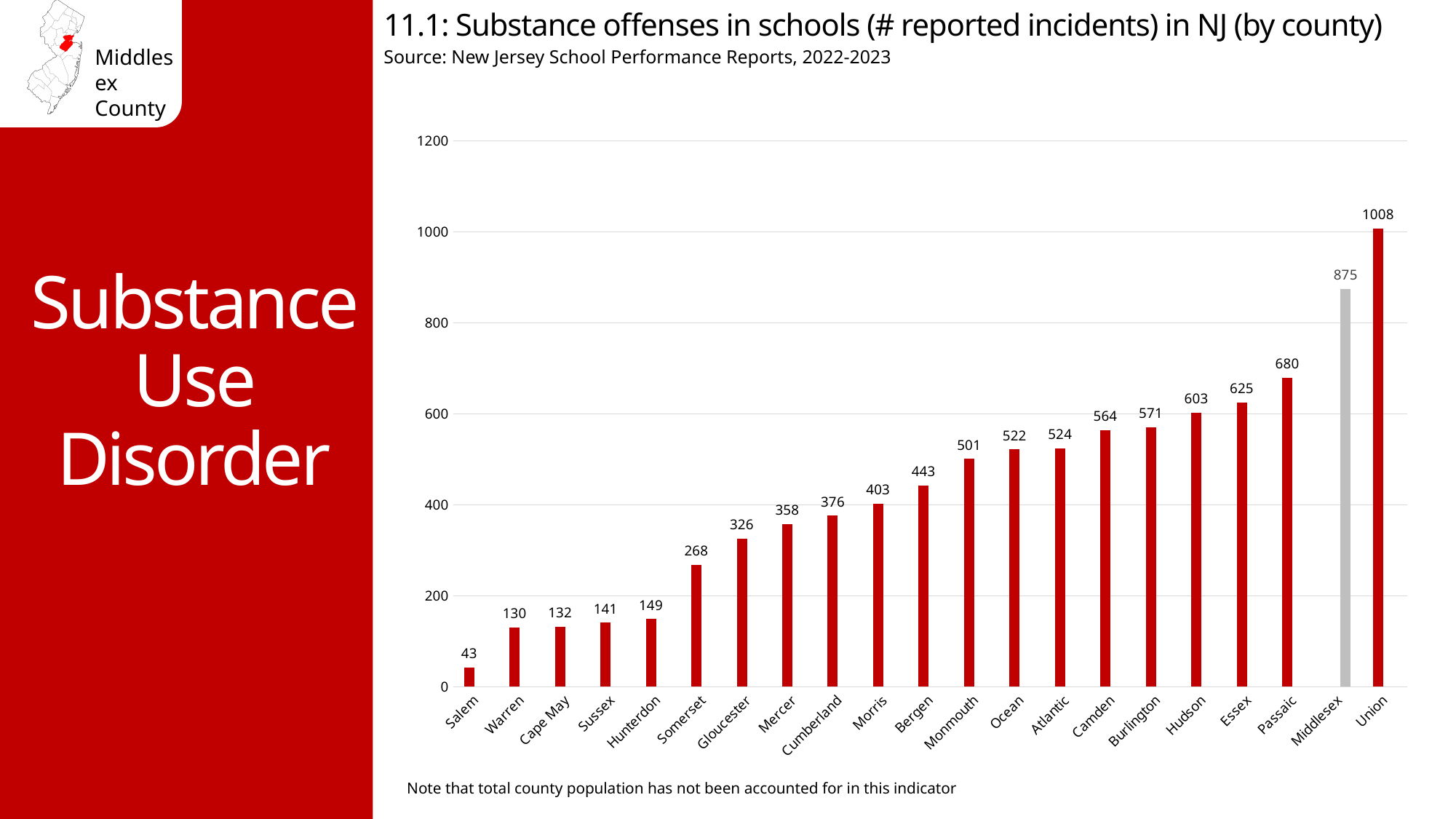
Which county has the highest number of reported incidents? Union How many counties are shown on the x axis? 21 What is the value shown for Bergen? 443 What is the difference between the values for Passaic and Essex? 55 Which county has the lowest number of reported incidents? Salem What is the value shown for Hunterdon? 149 What is the difference between the values for Union and Middlesex? 133 Which county's bar is coloured grey instead of red? Middlesex What is the number of reported substance offense incidents for Middlesex? 875 What kind of chart is shown on the slide? Bar chart Which has a higher value, Camden or Morris? Camden Is the value for Monmouth greater or less than 400? greater